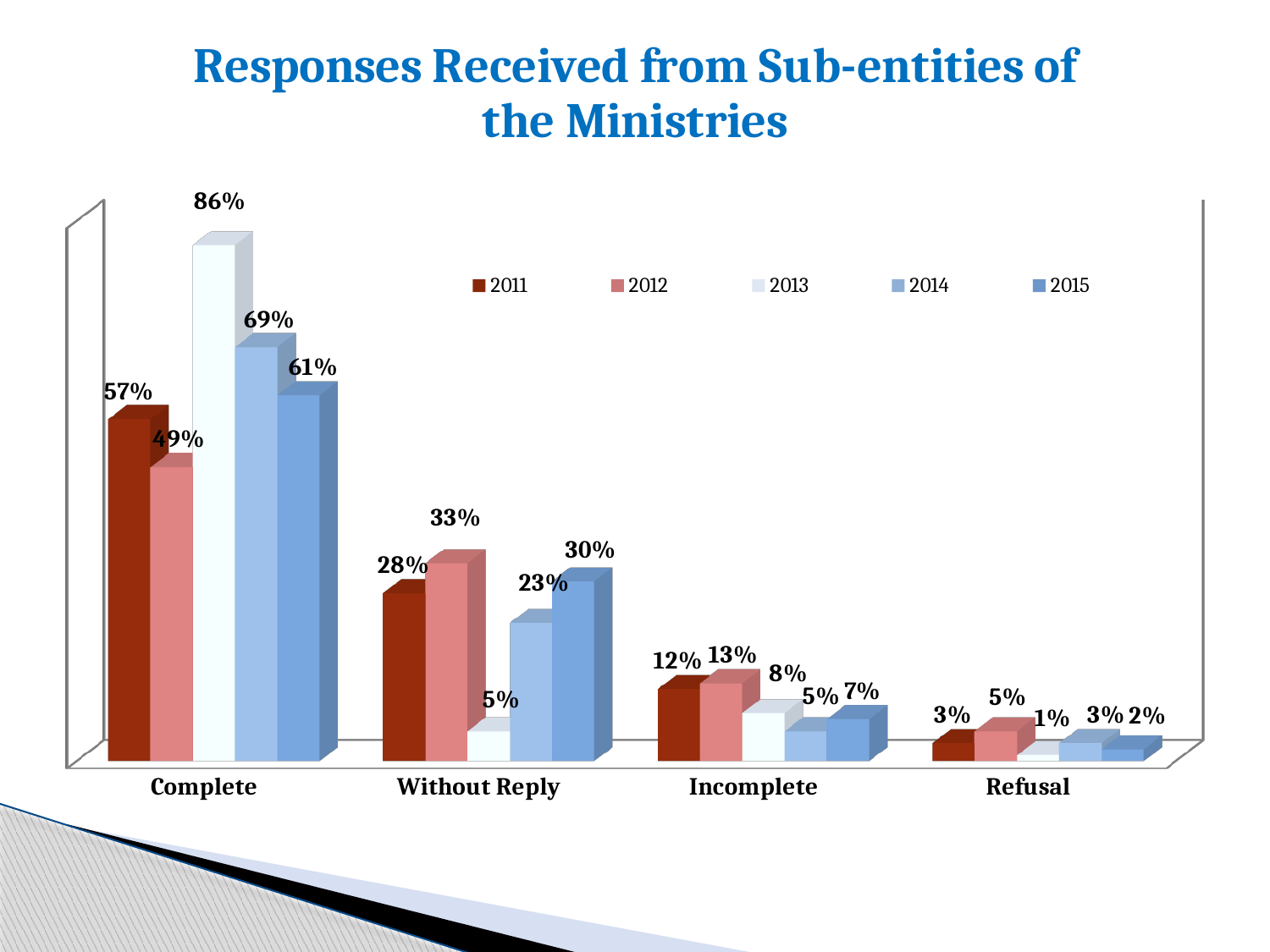
What is the difference between the 2012 and 2011 values in the Without Reply category? 5% Which is larger in the Incomplete category, the value for 2011 or the value for 2012? 2012 How many categories are shown on the x axis? 4 What is the difference between the 2014 and 2015 values in the Complete category? 8% Which year has the lowest value in the Without Reply category? 2013 What is the title of the chart? Responses Received from Sub-entities of the Ministries What is the value for 2014 in the Incomplete category? 5% What is the value for 2015 in the Without Reply category? 30% Which year has the highest value in the Complete category? 2013 What kind of chart is shown on the slide? Bar chart What is the value for 2013 in the Complete category? 86% How many series does the legend list? 5